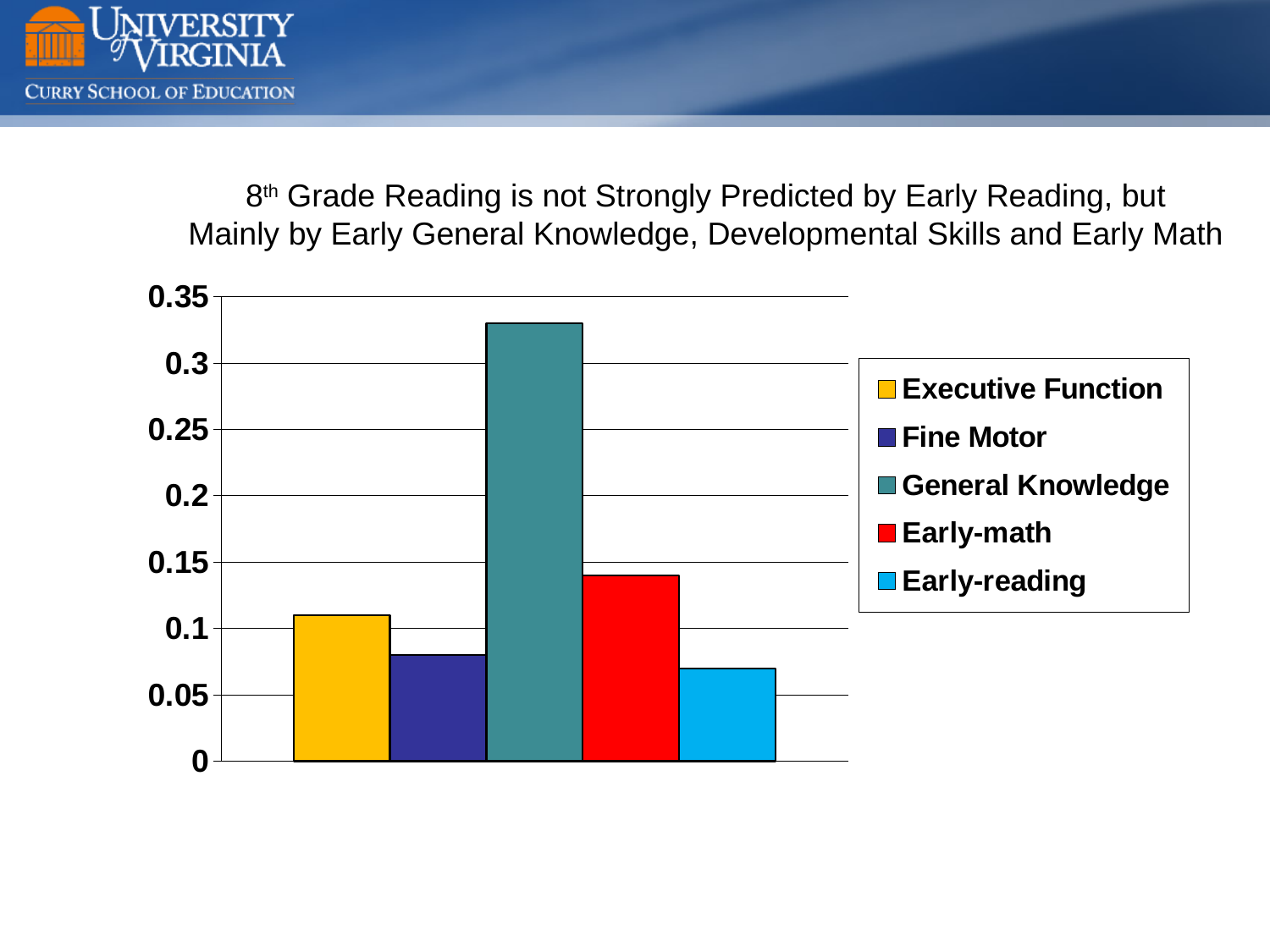
Is the value for General Knowledge greater or less than 0.3? greater How many series does the legend list? 5 Which is larger, the value for General Knowledge or the value for Early-math? General Knowledge Which is larger, the value for Early-math or the value for Executive Function? Early-math Is the value for Fine Motor greater or less than 0.1? less Is the value for Early-reading greater or less than 0.05? greater Which series has the highest bar? General Knowledge How many bars are plotted in the chart? 5 What is the highest value shown on the vertical axis? 0.35 What kind of chart is shown on the slide? bar chart